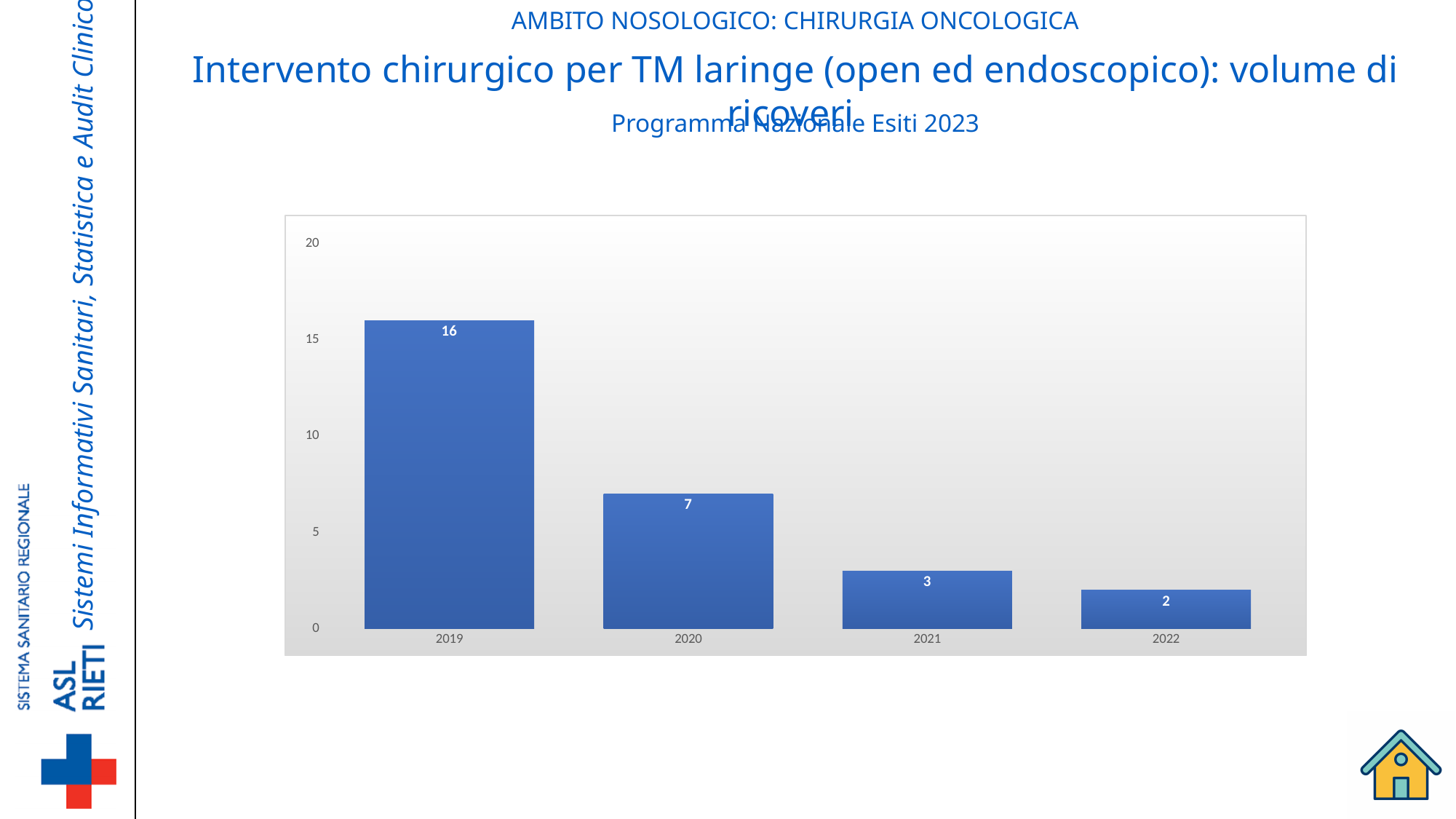
How many years are shown on the x axis? 4 What is the value for 2021? 3 Is the value for 2019 greater or less than 15? greater What is the value for 2022? 2 What is the value for 2019? 16 Which is larger, the value for 2020 or the value for 2021? 2020 Which year has the lowest value? 2022 What is the difference between the values for 2019 and 2020? 9 Which year has the highest value? 2019 Do the values rise or fall from 2019 to 2022? fall What is the value for 2020? 7 What kind of chart is shown on the slide? bar chart